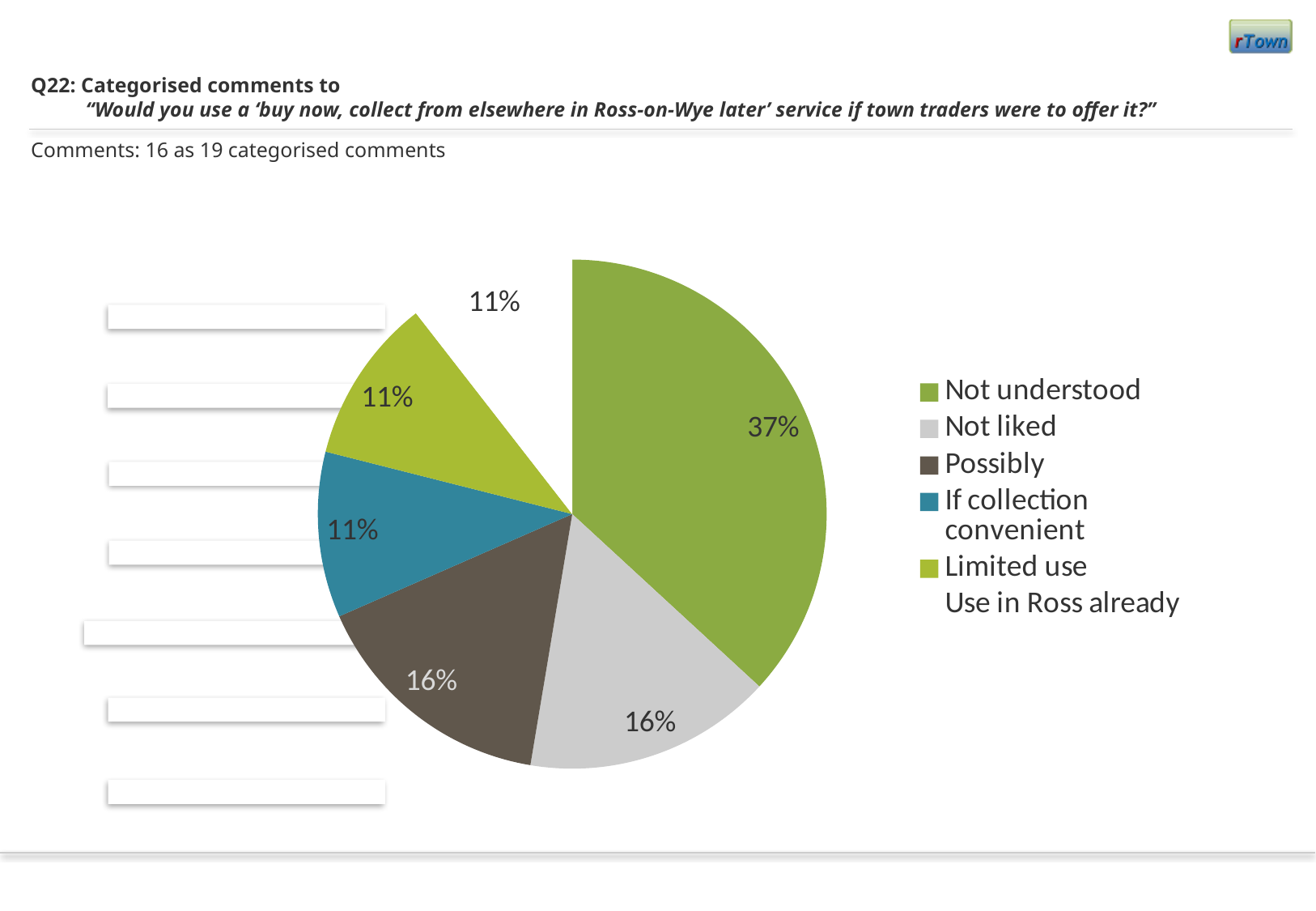
How many categorised comments does the slide say the chart is based on? 19 What is the value shown for 'Possibly'? 16% What is the value shown for 'Not liked'? 16% How many categories does the legend list? 6 What is the value shown for 'Limited use'? 11% What is the value shown for 'If collection convenient'? 11% What colour is the 'Not understood' slice? green What share of the pie does 'Not understood' take? 37% What kind of chart is shown on the slide? pie chart Which is larger, 'Not understood' or 'Possibly'? Not understood Which category has the largest slice of the pie? Not understood What is the difference in percentage points between 'Not understood' and 'Not liked'? 21